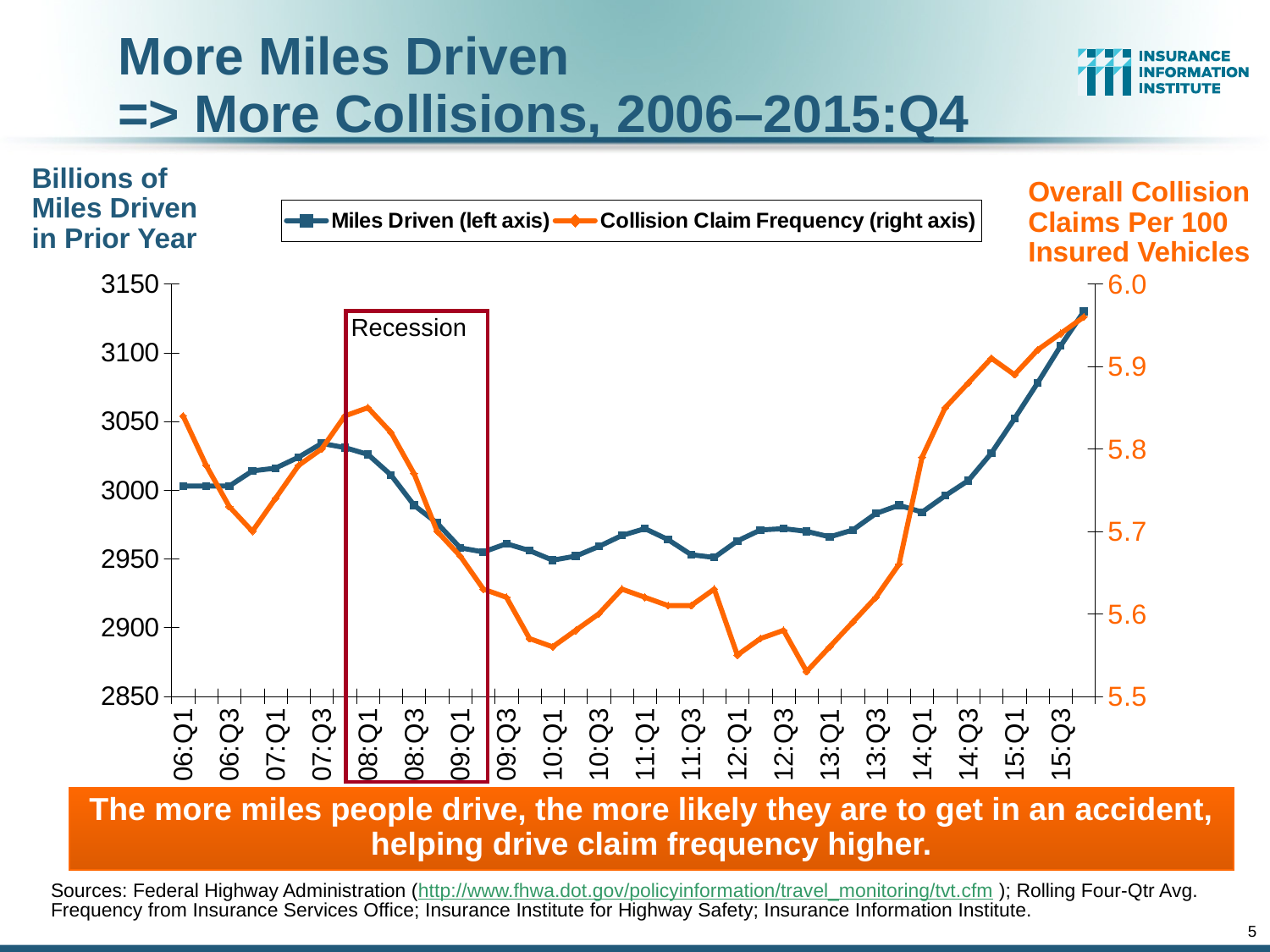
Which is larger, the Miles Driven value at 07:Q3 or at 10:Q1? 07:Q3 Is the Miles Driven value at 10:Q1 greater or less than 3000? less How many series does the legend list? 2 Which is larger, the Collision Claim Frequency at 08:Q1 or at 10:Q1? 08:Q1 What period is marked by the labeled box on the chart? Recession What kind of chart is shown on the slide? line chart Does the Collision Claim Frequency series rise or fall from 08:Q1 to 09:Q3? fall Is the Collision Claim Frequency value at 08:Q1 greater or less than 5.8? greater Which series is plotted against the right axis according to the legend? Collision Claim Frequency Does the Miles Driven series rise or fall from 13:Q3 to 15:Q3? rise Is the Collision Claim Frequency value at 13:Q1 greater or less than 5.6? less